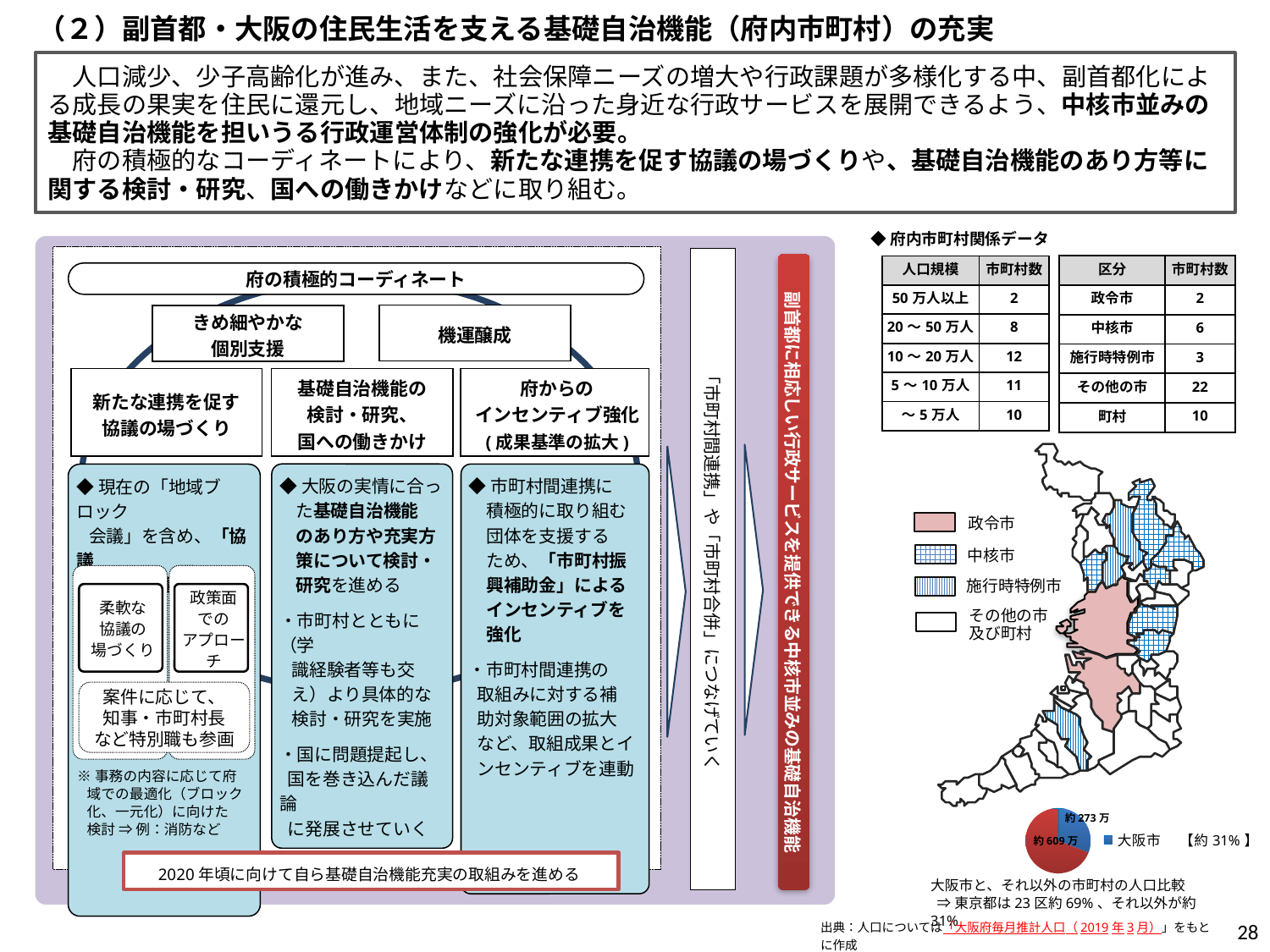
In the pie chart at the bottom right, what value is shown for 大阪市? 約273万 How many entries does the legend of the pie chart at the bottom right list? 1 In the pie chart at the bottom right, what value is shown for the slice other than 大阪市? 約609万 How many slices does the pie chart at the bottom right have? 2 What kind of chart is shown at the bottom right of the slide, below the map? pie chart What is the legend entry shown next to the pie chart at the bottom right? 大阪市 In the pie chart at the bottom right, what share of the total does 大阪市 account for, as printed on the slide? 約31% According to the caption under the pie chart, what does the chart compare? 大阪市と、それ以外の市町村の人口比較 In the pie chart at the bottom right, which slice is larger: 大阪市 (約273万) or the rest of the municipalities (約609万)? the rest of the municipalities (約609万) In the pie chart at the bottom right, which slice is the smallest? 大阪市